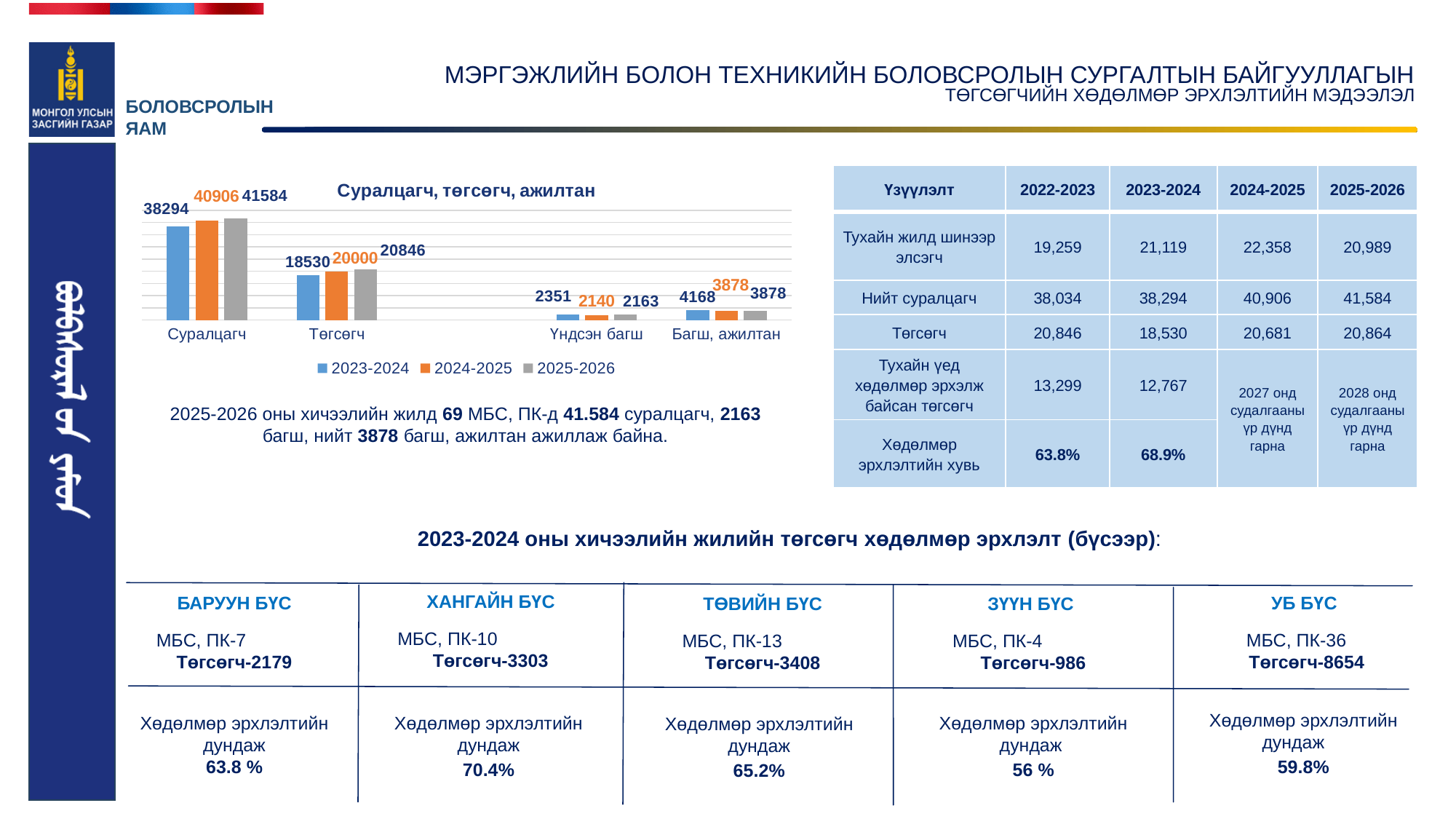
Which category has the highest value in the 2025-2026 series? Суралцагч Which is larger for Багш, ажилтан: the 2023-2024 value or the 2024-2025 value? 2023-2024 What is the value for Үндсэн багш in the 2023-2024 series? 2351 What type of chart is shown on the slide? bar chart What is the value for Суралцагч in the 2025-2026 series? 41584 What is the difference between the 2025-2026 and 2023-2024 values for Суралцагч? 3290 How many series does the chart legend list? 3 Which category has the lowest value in the 2024-2025 series? Үндсэн багш How many categories are shown on the x axis of the chart? 4 What is the value for Багш, ажилтан in the 2025-2026 series? 3878 What is the value for Төгсөгч in the 2024-2025 series? 20000 What is the title of the chart? Суралцагч, төгсөгч, ажилтан